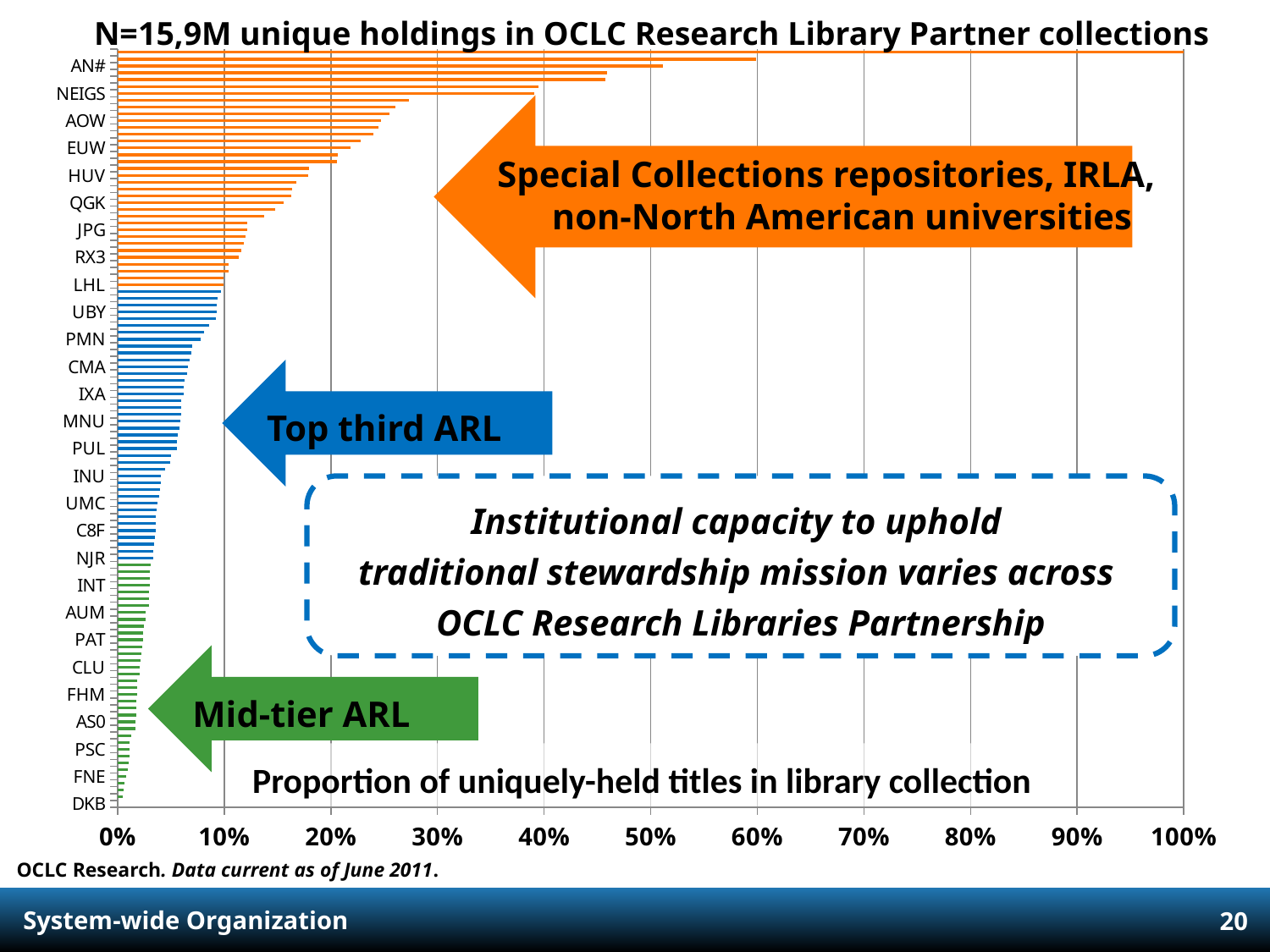
Is the value for DKB greater or less than 10%? less Is the value for QGK greater or less than 20%? less Which has a larger value, AOW or PAT? AOW What does the x axis of the chart measure, according to the label printed on the chart? Proportion of uniquely-held titles in library collection Which has a larger value, NEIGS or DKB? NEIGS Is the value for EUW greater or less than 30%? less What is the title of the chart? N=15,9M unique holdings in OCLC Research Library Partner collections What kind of chart is shown on the slide? bar chart Do the bar values rise or fall going from the top of the chart (AN#) to the bottom (DKB)? fall